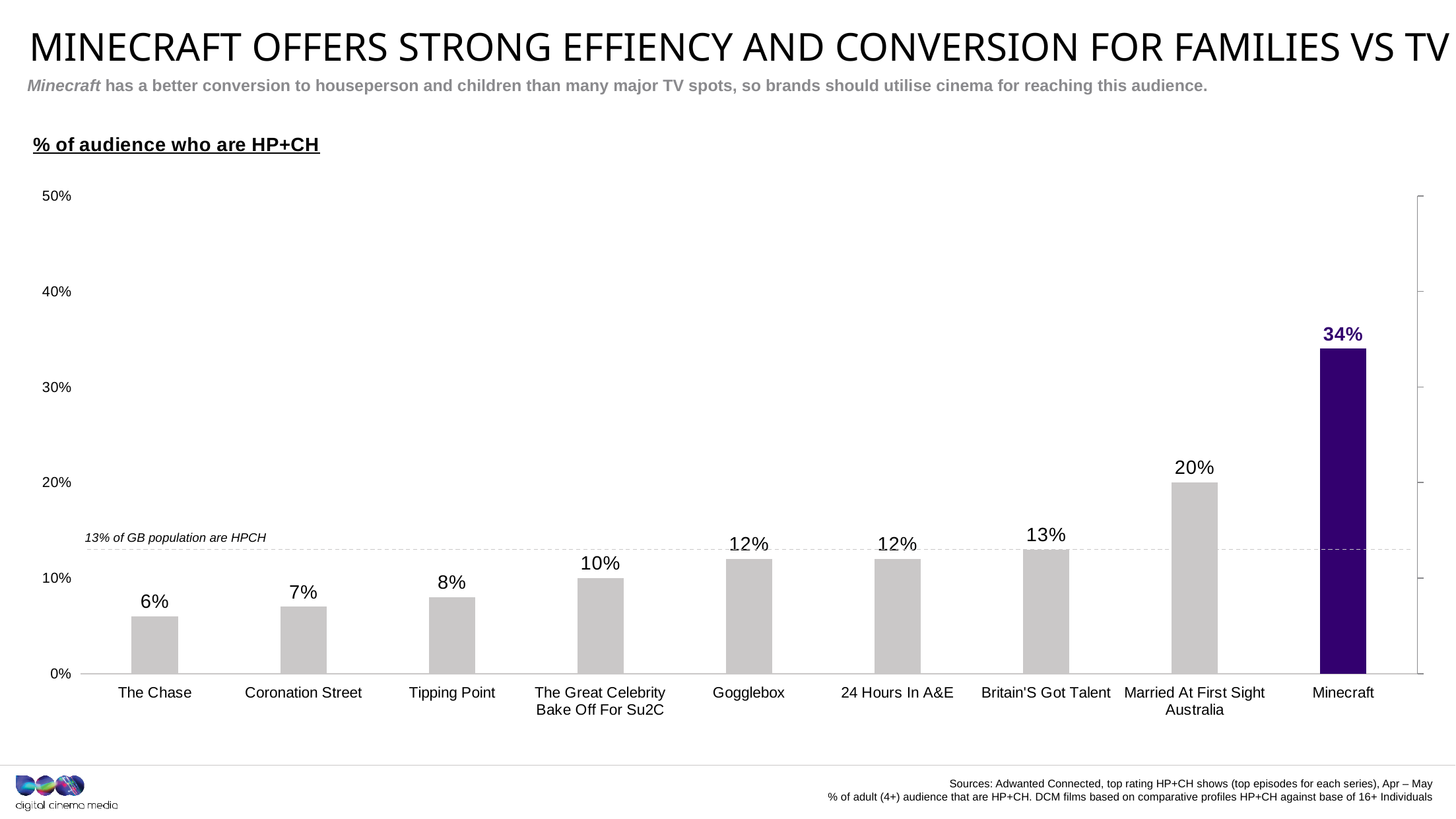
How many categories are shown on the x axis of the chart? 9 What is the value shown for The Great Celebrity Bake Off For Su2C? 10% What is the difference between the values for Britain'S Got Talent and The Chase? 7% Which category has the lowest value in the chart? The Chase Which has a higher value, Tipping Point or Gogglebox? Gogglebox Which category has the highest value in the chart? Minecraft What is the value shown for Married At First Sight Australia? 20% What is the difference between the values for Minecraft and Married At First Sight Australia? 14% What percentage of the GB population are HPCH according to the dashed reference line? 13% Is the value for Minecraft greater or less than 30%? greater What percentage of the audience for Minecraft are HP+CH? 34% What kind of chart is shown on the slide? Bar chart